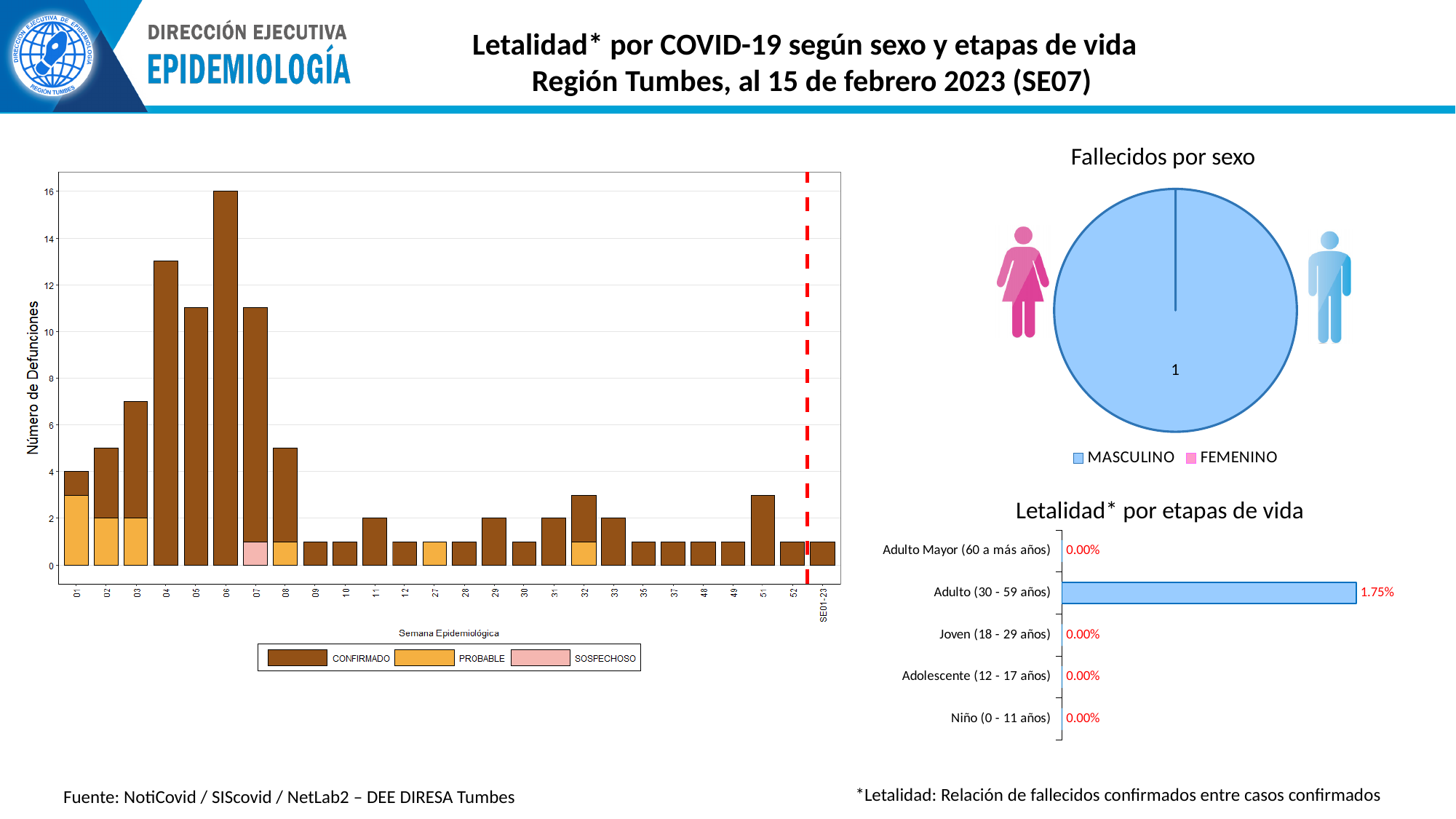
In the bar chart on the left (Número de Defunciones by Semana Epidemiológica), which week has the highest number of deaths? 06 In the bar chart on the left, is the value for week 04 greater or less than 12? greater In the 'Letalidad* por etapas de vida' chart, what is the value for Adulto (30 - 59 años)? 1.75% How many entries does the legend of the 'Fallecidos por sexo' chart list? 2 How many series does the legend of the bar chart on the left list? 3 In the 'Letalidad* por etapas de vida' chart, which age group has the highest letalidad? Adulto (30 - 59 años) What kind of chart is 'Fallecidos por sexo'? pie chart In the 'Fallecidos por sexo' pie chart, what value is printed on the MASCULINO slice? 1 How many age groups are shown in the 'Letalidad* por etapas de vida' chart? 5 In the 'Letalidad* por etapas de vida' chart, what is the value for Niño (0 - 11 años)? 0.00% In the bar chart on the left, what is the total number of deaths for week 06? 16 What kind of chart is the chart on the left showing Número de Defunciones? bar chart